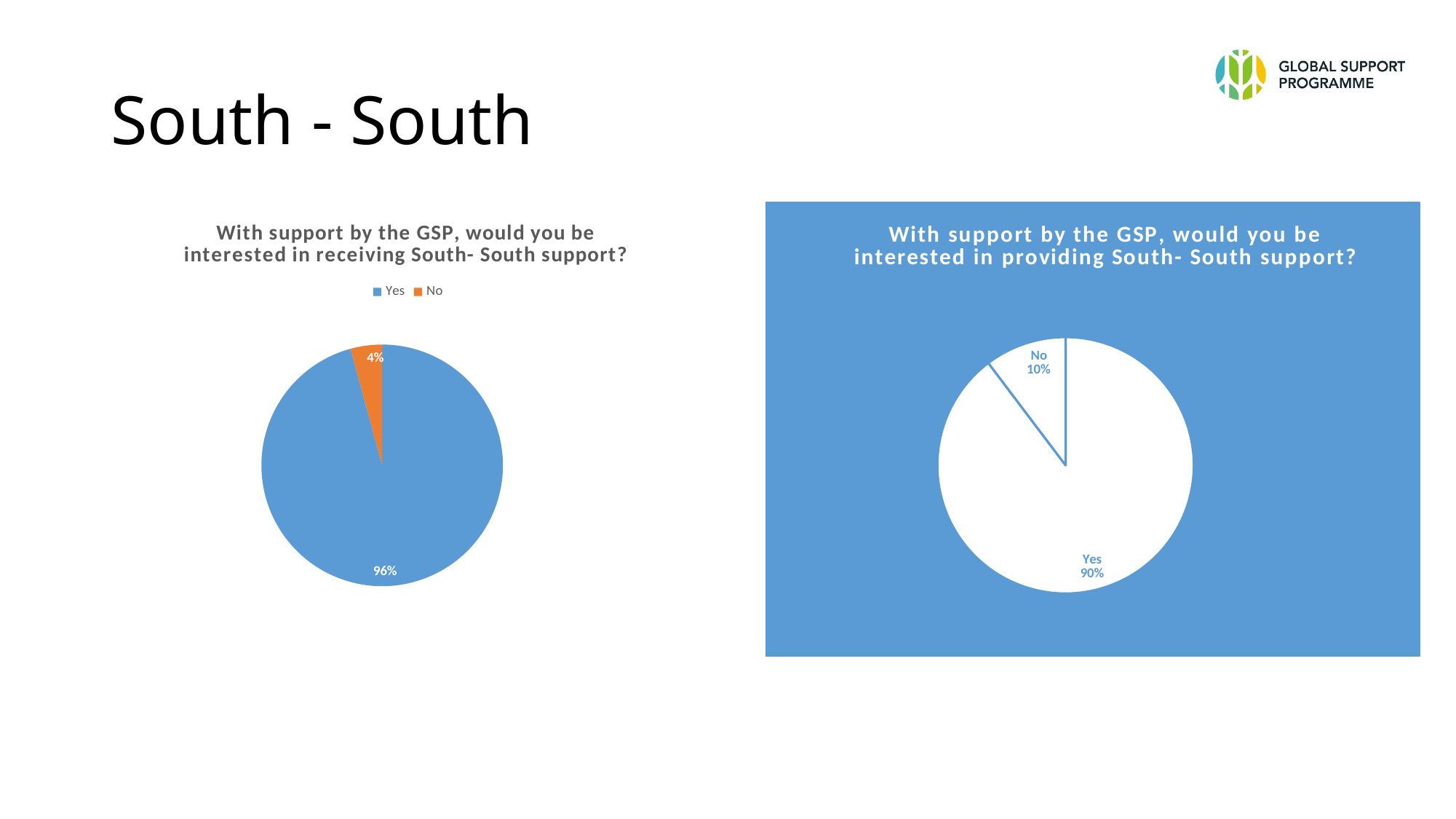
In the right chart (providing South-South support), what share of respondents answered No? 10% In the left chart (receiving South-South support), what share of respondents answered No? 4% In the left chart (receiving South-South support), what share of respondents answered Yes? 96% In the left chart (receiving South-South support), what is the difference in percentage points between Yes and No? 92 percentage points In the right chart (providing South-South support), which response has the smallest slice? No In the left chart (receiving South-South support), which response has the largest slice? Yes How many entries does the legend of the left chart (receiving South-South support) list? 2 In the right chart (providing South-South support), what is the difference in percentage points between Yes and No? 80 percentage points What kind of chart is the left chart about receiving South-South support? Pie chart What kind of chart is the right chart about providing South-South support? Pie chart Which is larger: the No share in the left chart (receiving) or the No share in the right chart (providing)? The No share in the right chart (providing)